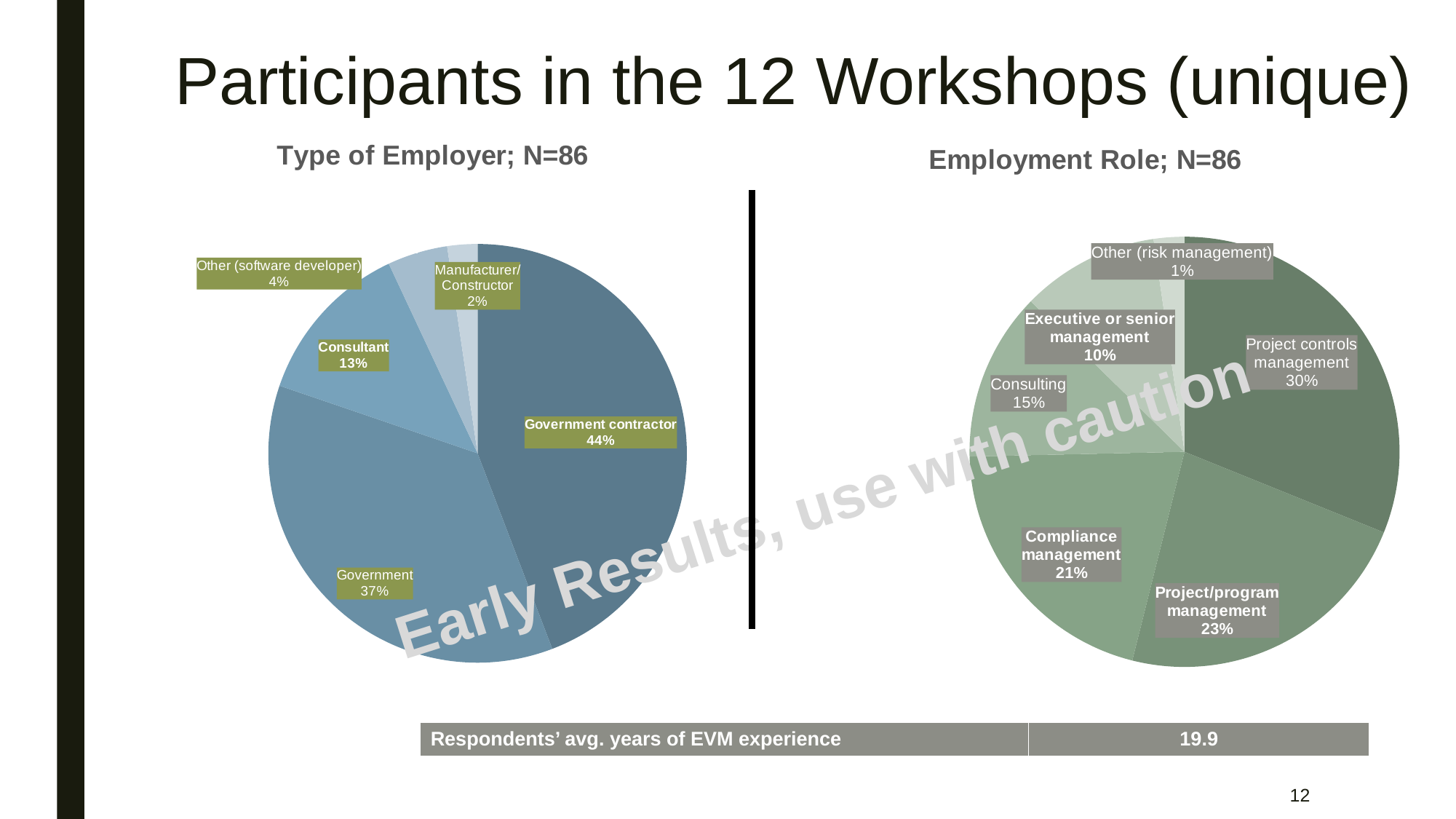
In the 'Type of Employer; N=86' chart, how many categories are shown? 5 In the 'Employment Role; N=86' chart, what share is Project controls management? 30% In the 'Type of Employer; N=86' chart, what is the difference in percentage points between Government contractor and Government? 7 In the 'Employment Role; N=86' chart, which is larger: Consulting or Executive or senior management? Consulting What type of chart is used for 'Employment Role; N=86'? Pie chart In the 'Employment Role; N=86' chart, how many categories are shown? 6 In the 'Type of Employer; N=86' chart, which category has the largest slice? Government contractor In the 'Type of Employer; N=86' chart, what share of participants are government contractors? 44% In the 'Type of Employer; N=86' chart, what percentage is labelled Consultant? 13% In the 'Employment Role; N=86' chart, which role has the smallest share? Other (risk management) In the 'Type of Employer; N=86' chart, which category has the smallest slice? Manufacturer/Constructor In the 'Employment Role; N=86' chart, what percentage is Compliance management? 21%